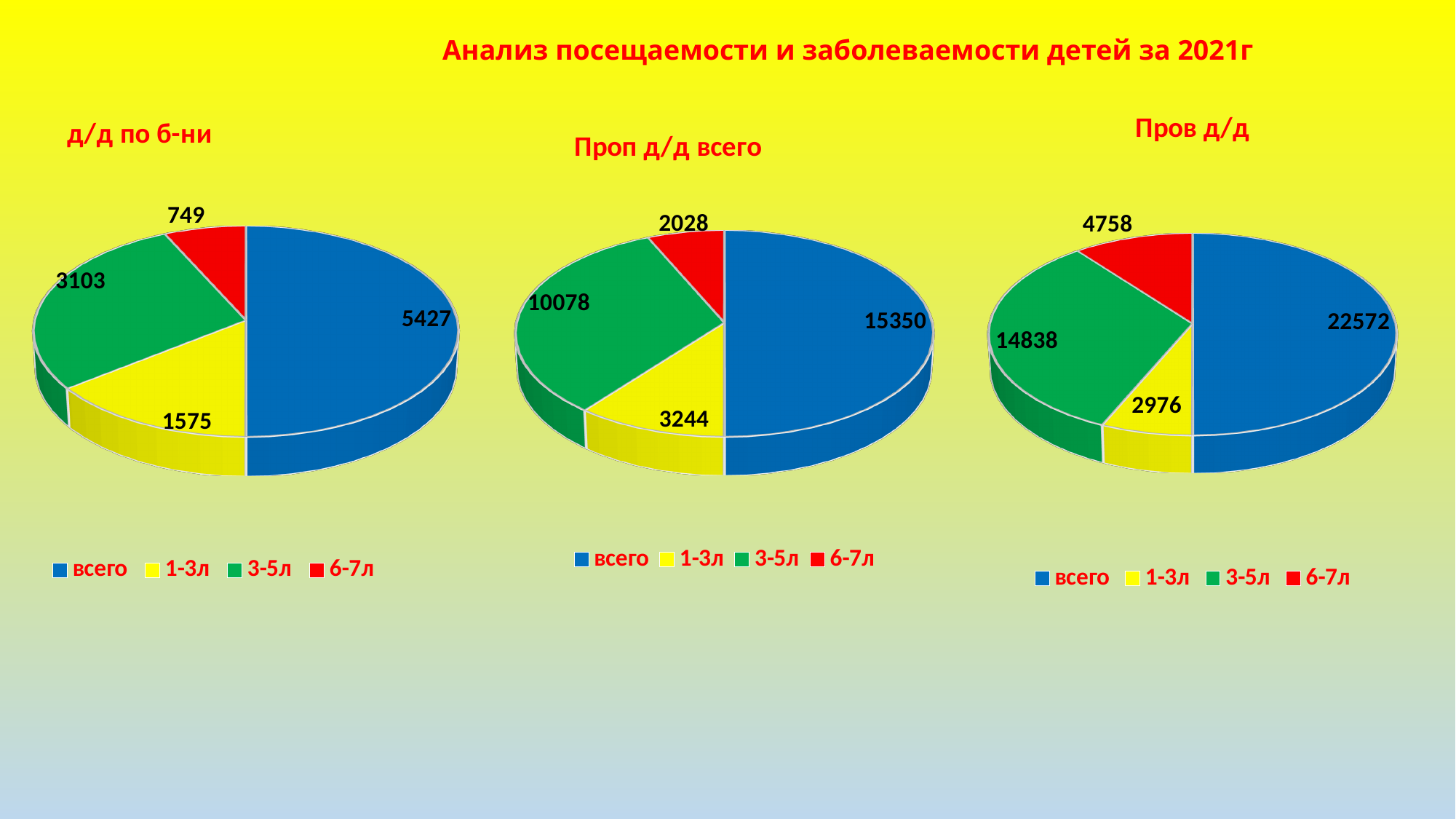
In the "Пров д/д" chart, which is larger, the value for 1-3л or the value for 6-7л? 6-7л What kind of chart is used for "д/д по б-ни"? pie chart In the "д/д по б-ни" chart, what share of the pie does the всего slice represent? 50% In the "д/д по б-ни" chart, what is the difference between the 3-5л value and the 6-7л value? 2354 In the "Пров д/д" chart, what is the value for 6-7л? 4758 How many entries does the legend of the "Пров д/д" chart list? 4 In the "д/д по б-ни" chart, what is the value for всего? 5427 In the "Пров д/д" chart, which category has the smallest value? 1-3л In the "Проп д/д всего" chart, what is the value for 3-5л? 10078 How many slices does the "д/д по б-ни" pie chart have? 4 In the "Проп д/д всего" chart, which category has the largest value? всего In the "Проп д/д всего" chart, what is the difference between the 3-5л value and the 1-3л value? 6834